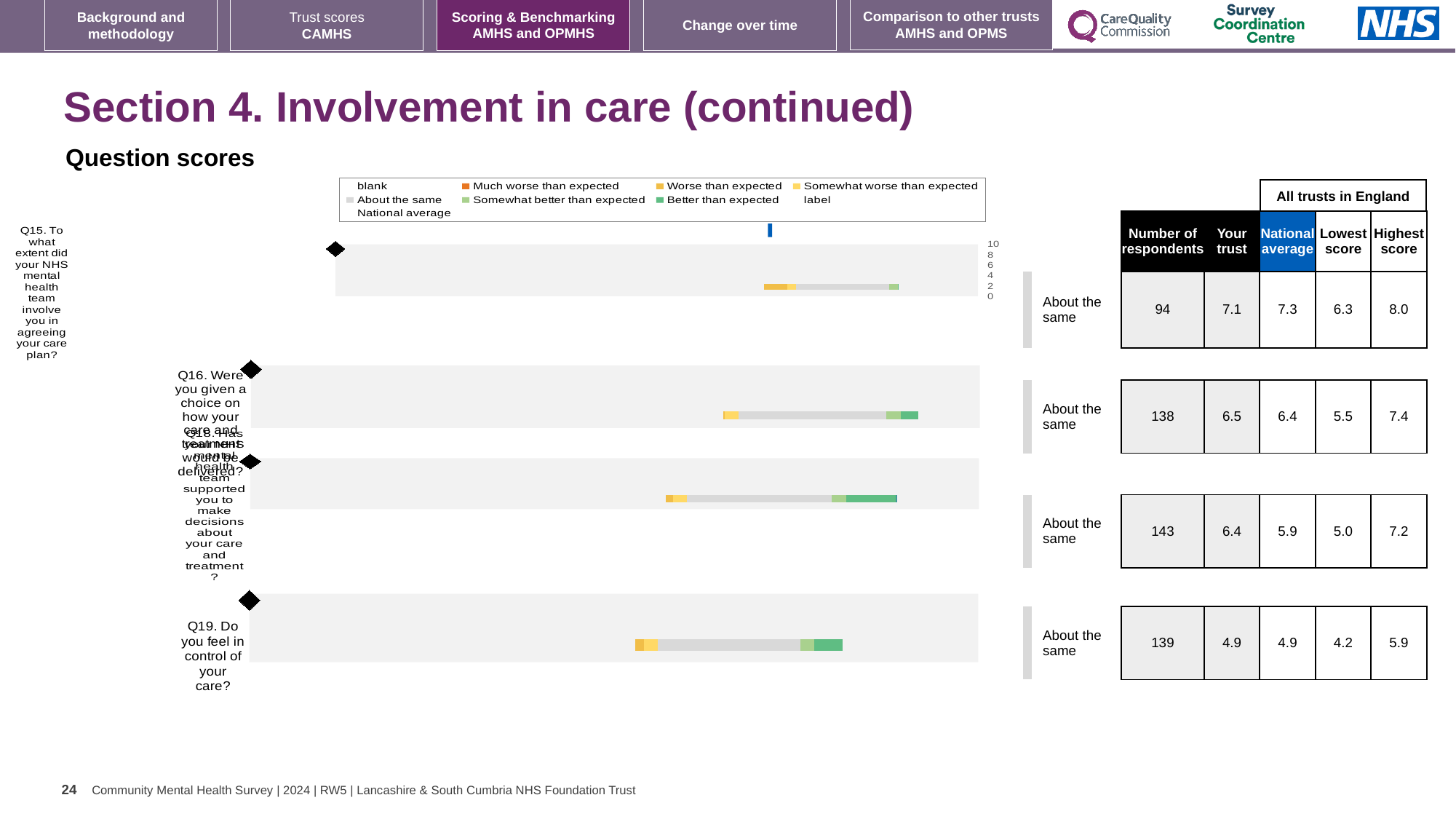
What kind of chart is used to show the question scores on this slide? bar chart What is the highest score among all trusts in England for Q19 (feeling in control of your care)? 5.9 How many respondents answered Q18 (supported to make decisions about your care and treatment)? 143 Which question has the highest 'Your trust' score on this slide? Q15 How many questions (Q15, Q16, Q18, Q19) have a score bar plotted on this slide? 4 What benchmark category is shown for all four questions on this slide? About the same What is the 'Your trust' score for Q15 (involving you in agreeing your care plan)? 7.1 What is the national average score for Q16 (choice on how your care and treatment would be delivered)? 6.4 For Q18, what is the difference between the 'Your trust' score and the national average? 0.5 Which question has the lowest 'Your trust' score on this slide? Q19 For Q16, which is larger: the 'Your trust' score or the national average? Your trust For Q15, which is larger: the 'Your trust' score or the national average? National average